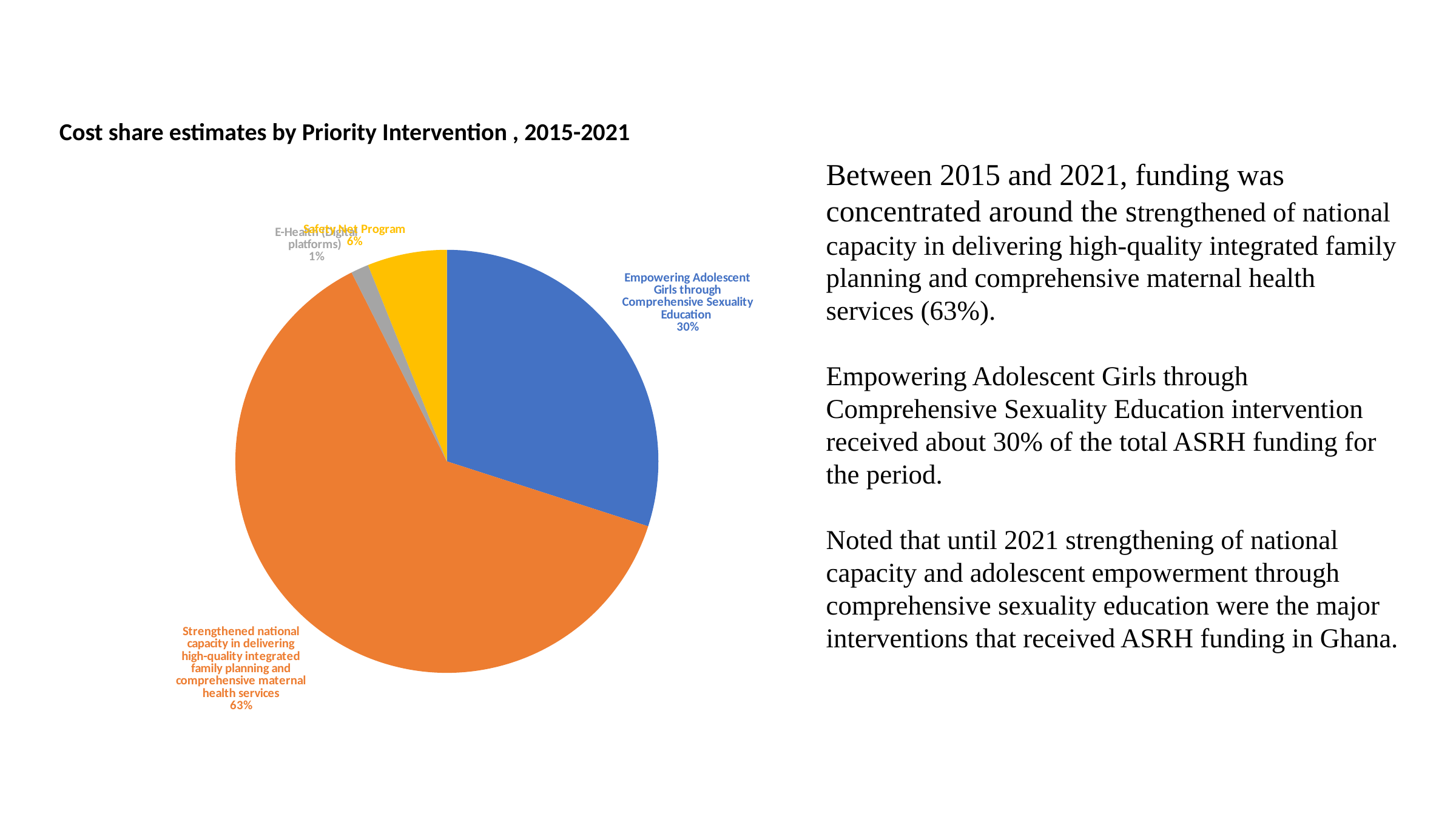
Which priority intervention has the smallest share of the pie? E-Health (Digital platforms) What is the difference in percentage points between the Strengthened national capacity slice and the Empowering Adolescent Girls slice? 33 What kind of chart is shown on the slide? Pie chart What is the title of the chart? Cost share estimates by Priority Intervention , 2015-2021 What share of the pie does the Safety Net Program have? 6% What share of the pie does E-Health (Digital platforms) have? 1% What share of the pie does Empowering Adolescent Girls through Comprehensive Sexuality Education have? 30% What colour is the slice for Empowering Adolescent Girls through Comprehensive Sexuality Education? Blue How many slices does the pie chart have? 4 Which priority intervention has the largest share of the pie? Strengthened national capacity in delivering high-quality integrated family planning and comprehensive maternal health services Which is larger, the Safety Net Program slice or the E-Health (Digital platforms) slice? Safety Net Program